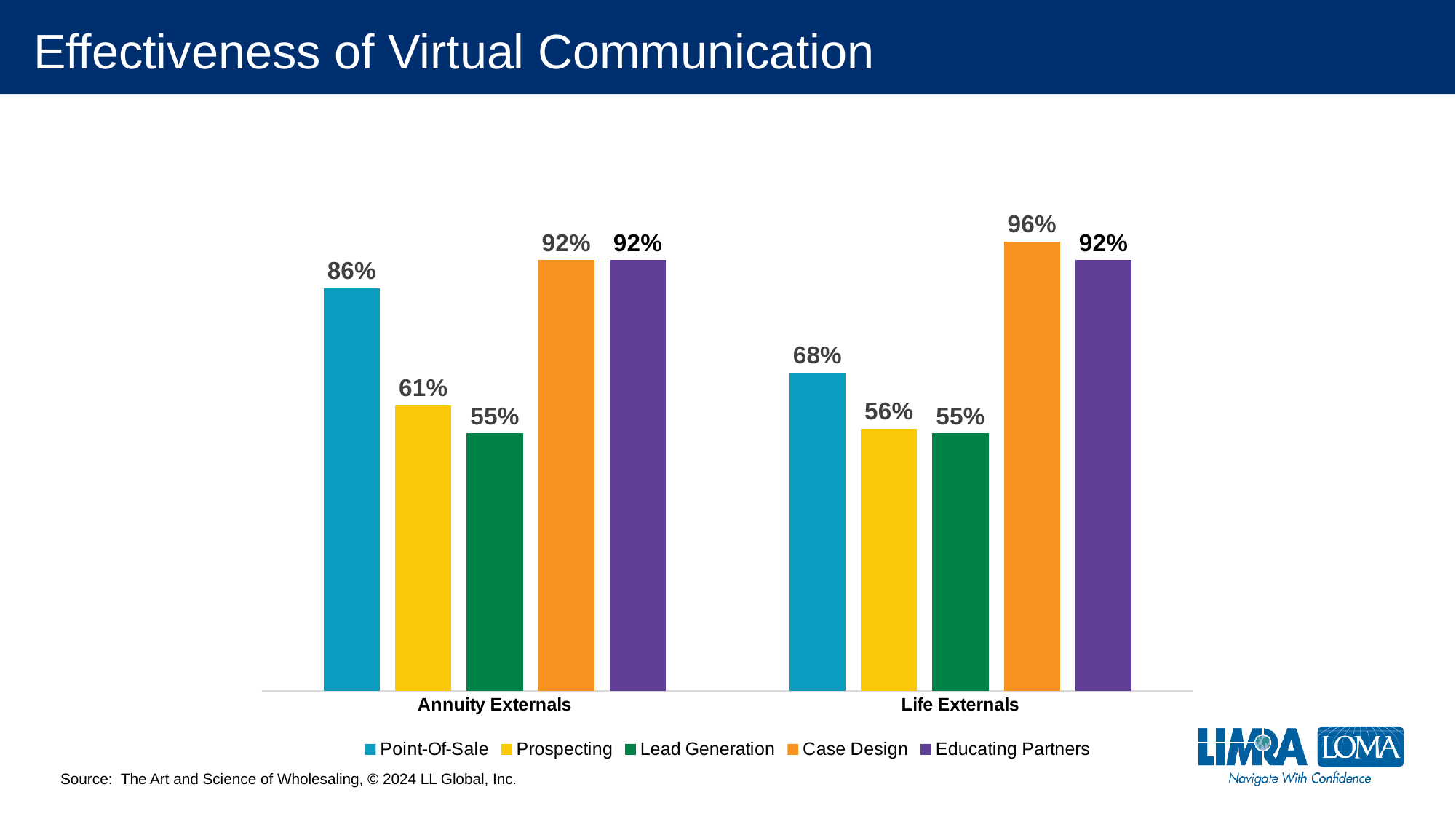
What is the difference between the Point-Of-Sale values for Annuity Externals and Life Externals? 18% Which series has the highest value for Life Externals? Case Design What is the value for Point-Of-Sale among Annuity Externals? 86% What is the value for Case Design among Life Externals? 96% What is the value for Educating Partners among Annuity Externals? 92% What is the value for Prospecting among Life Externals? 56% Which series has the lowest value for Annuity Externals? Lead Generation How many categories are shown on the x axis? 2 Which is larger: Prospecting for Annuity Externals or Prospecting for Life Externals? Annuity Externals What colour represents Case Design in the chart? Orange What kind of chart is shown on the slide? Bar chart How many series does the legend list? 5